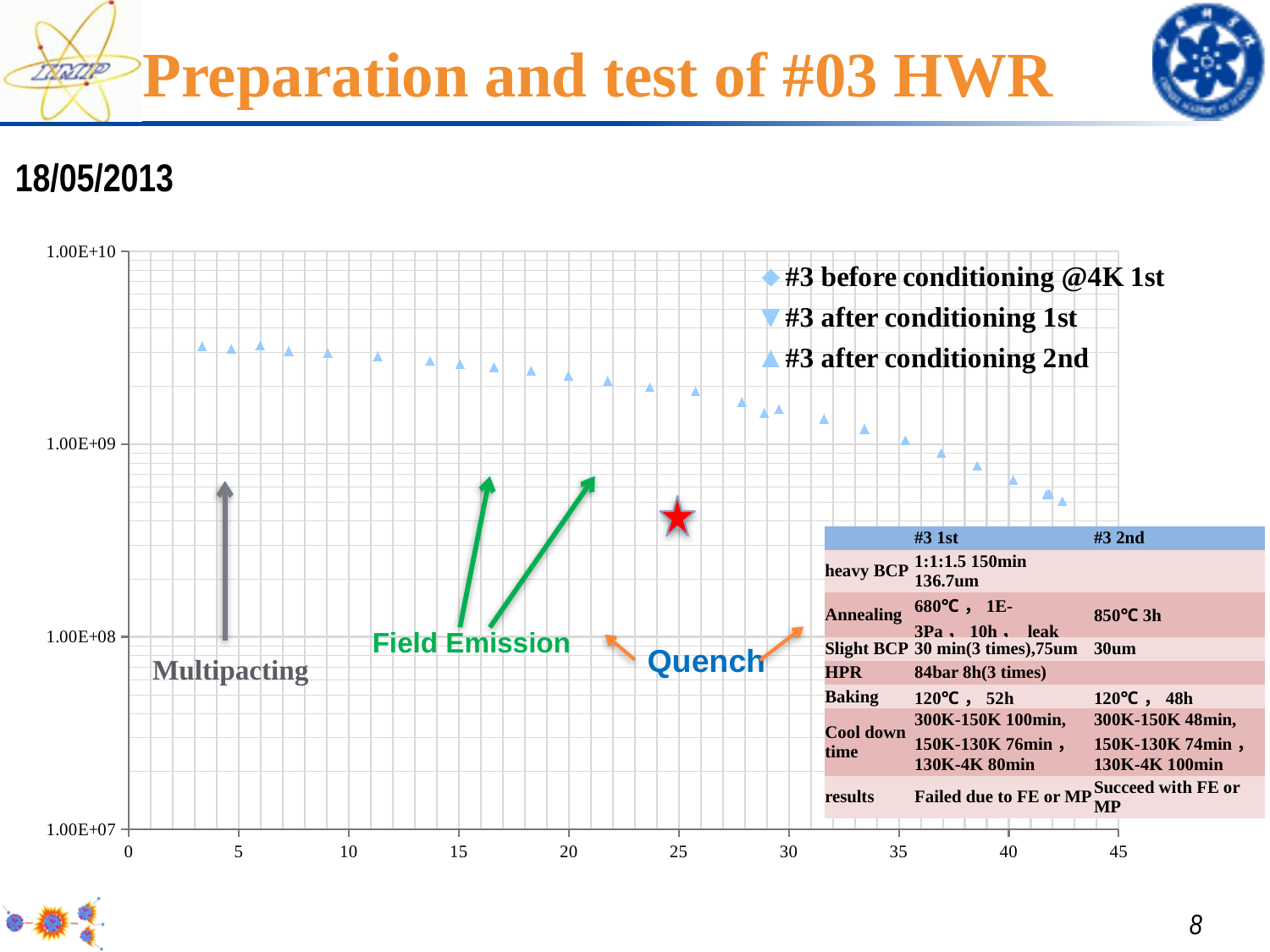
Is the value of the '#3 after conditioning 2nd' series at x = 40 greater or less than 1.00E+09? less Which series is listed first in the chart legend? #3 before conditioning @4K 1st What is the highest tick value shown on the chart's y axis? 1.00E+10 Is the value of the '#3 after conditioning 2nd' series at x = 5 greater or less than 1.00E+09? greater Do the plotted values of the '#3 after conditioning 2nd' series rise or fall as the x value increases? fall How many series does the chart legend list? 3 Which series is listed last in the chart legend? #3 after conditioning 2nd Is the value of the '#3 after conditioning 2nd' series at x = 42 greater or less than 1.00E+08? greater What kind of chart is shown on the slide? scatter chart Which is larger for the '#3 after conditioning 2nd' series: the value at x = 5 or the value at x = 40? the value at x = 5